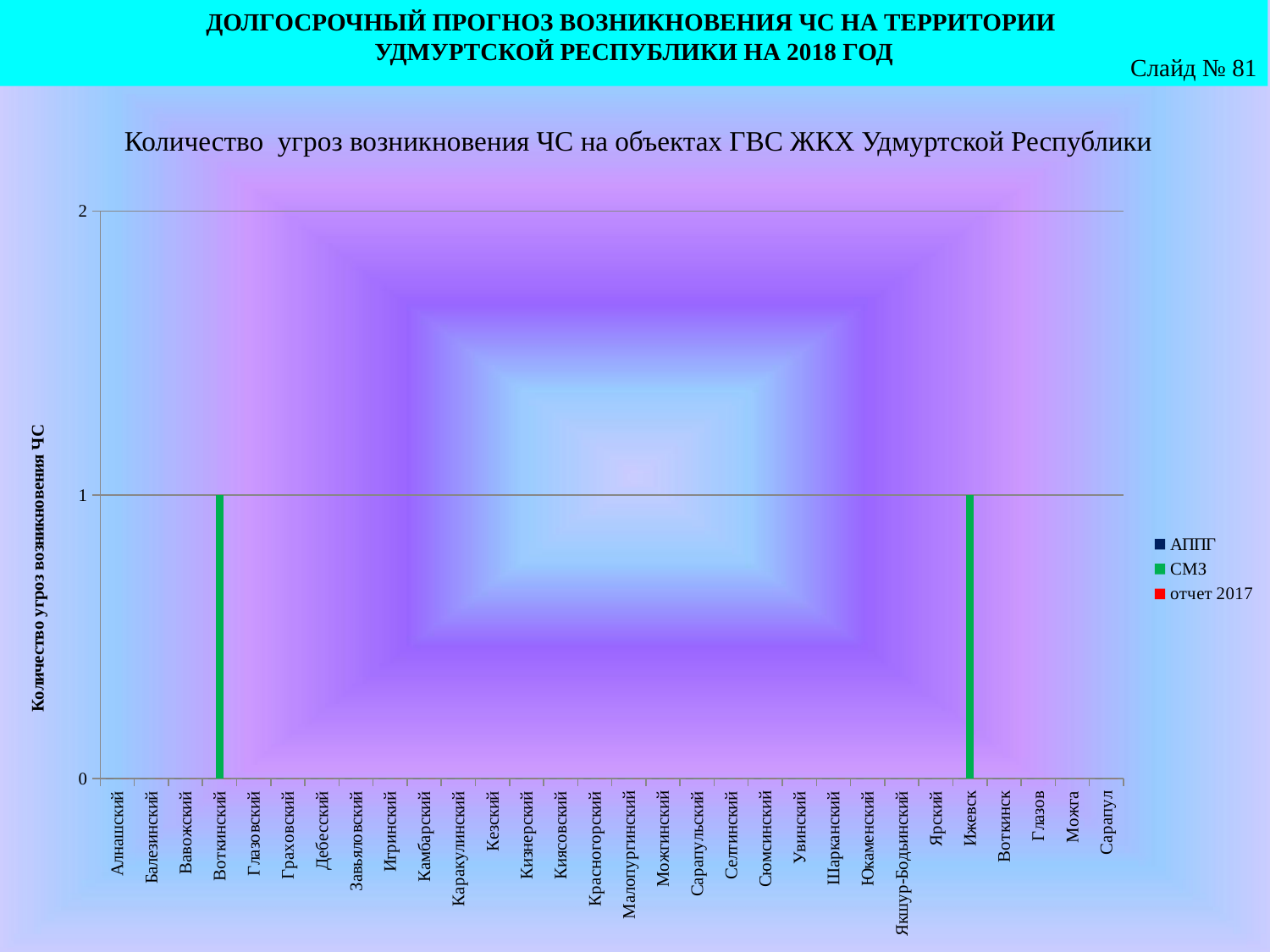
What is the title of the chart? Количество угроз возникновения ЧС на объектах ГВС ЖКХ Удмуртской Республики What is the highest value shown on the y axis? 2 How many categories are shown on the x axis? 30 What kind of chart is shown on the slide? bar chart What are the series names listed in the legend? АППГ, СМЗ, отчет 2017 What is the difference between the СМЗ values for Воткинский and Ижевск? 0 Which categories have a visible СМЗ bar? Воткинский and Ижевск What is the СМЗ value for Воткинский? 1 How many series does the legend list? 3 Which is larger, the СМЗ value for Ижевск or the СМЗ value for Алнашский? Ижевск What is the СМЗ value for Ижевск? 1 Is the СМЗ value for Воткинский greater or less than 2? less